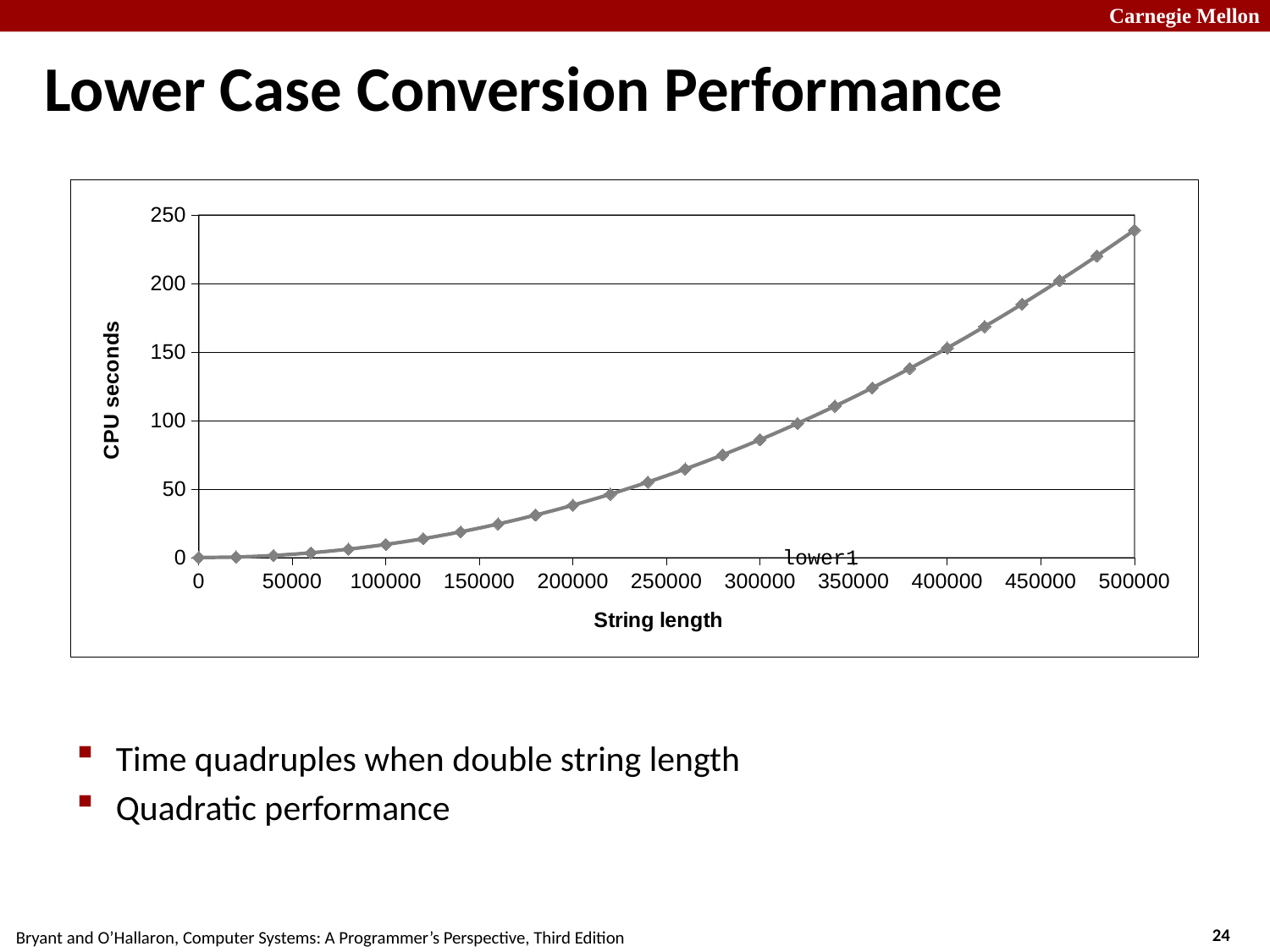
What kind of chart is shown on the slide? line chart Is the CPU time at a string length of 400000 greater or less than 100? greater Is the CPU time at a string length of 500000 greater or less than 200? greater Do the CPU seconds rise or fall as string length increases? rise At which string length is the CPU time lowest? 0 Is the CPU time at a string length of 100000 greater or less than 50? less What is the title of the y axis of the chart? CPU seconds What is the title of the x axis of the chart? String length Which has the larger CPU time: a string length of 100000 or a string length of 400000? 400000 At which string length is the CPU time highest? 500000